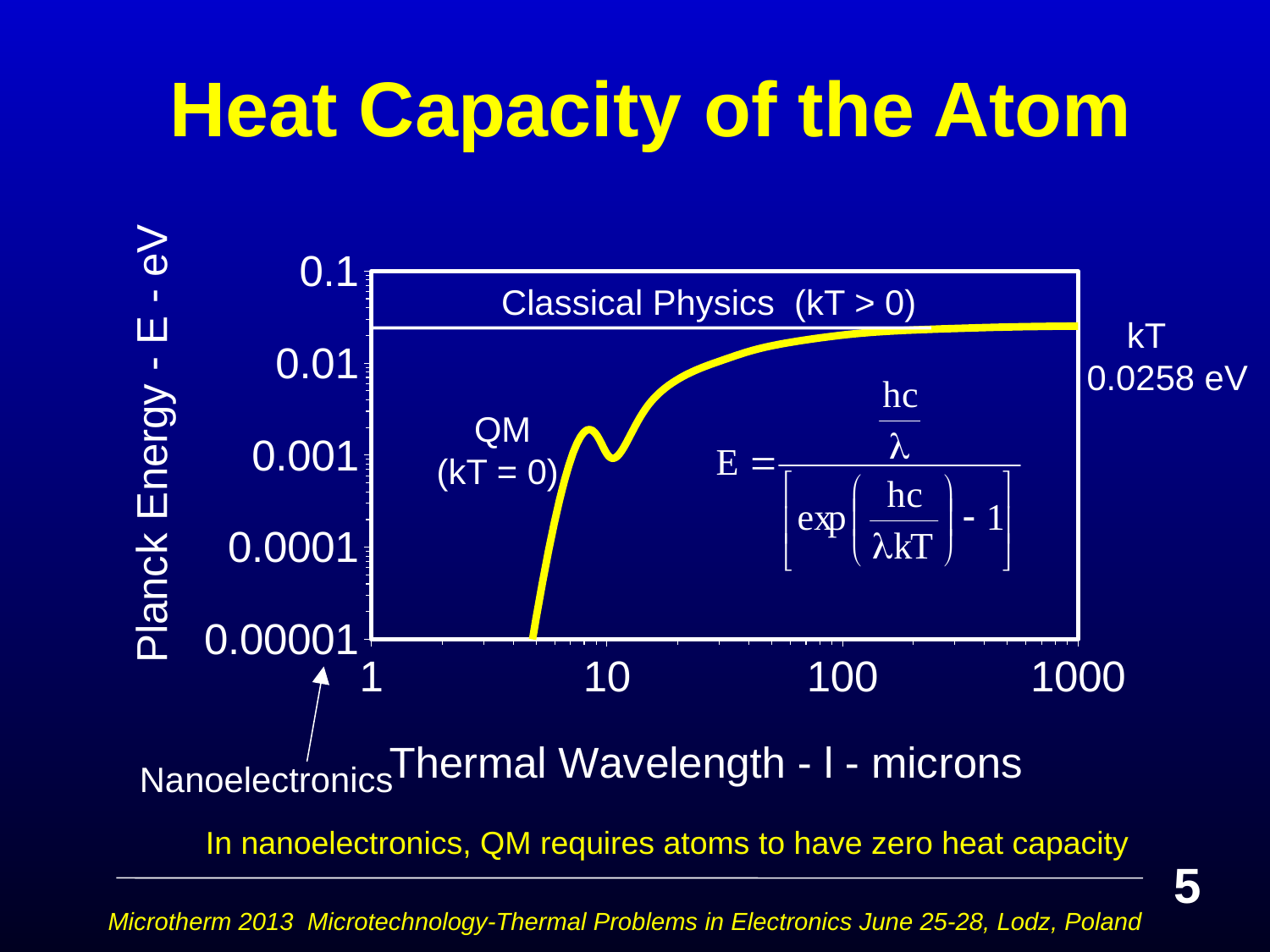
Is the value of the curve at a thermal wavelength of 1000 microns greater or less than 0.01 eV? greater Is the value of the curve at a thermal wavelength of 1000 microns greater or less than 0.1 eV? less What value of kT is printed next to the chart? 0.0258 eV What is the highest tick value shown on the x axis of the chart? 1000 What is the label of the y axis of the chart? Planck Energy - E - eV Is the value of the curve at a thermal wavelength of 10 microns greater or less than 0.01 eV? less How many curves are plotted on the chart? 1 Does the plotted Planck Energy curve generally rise or fall as the thermal wavelength increases from 1 to 1000 microns? rise What kind of chart is shown on the slide? line chart What is the title of the slide containing the chart? Heat Capacity of the Atom What is the lowest tick value shown on the y axis of the chart? 0.00001 Which region of the chart is labelled 'Classical Physics (kT > 0)': the upper part or the lower part? upper part